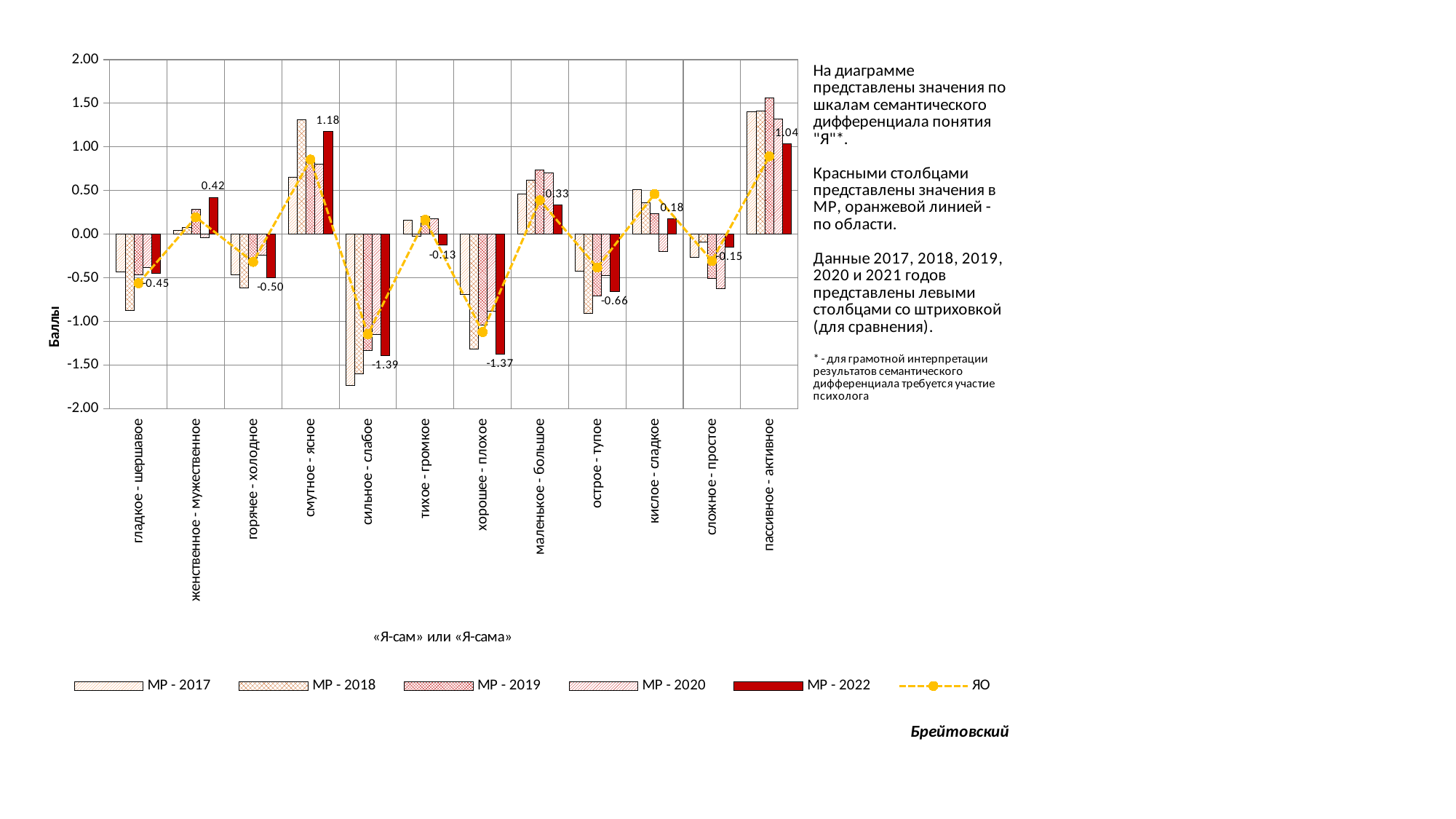
How many series does the legend list? 6 How many categories are shown on the x axis? 12 Which category has the highest МР - 2022 value? смутное - ясное What is the МР - 2022 value for острое - тупое? -0.66 Is the МР - 2017 value for гладкое - шершавое greater or less than -0.50? greater What is the МР - 2022 value for смутное - ясное? 1.18 What is the difference between the МР - 2022 values for смутное - ясное and пассивное - активное? 0.14 What kind of chart is shown on the slide? A bar chart combined with a line chart What is the title of the vertical axis? Баллы Which category has the lowest МР - 2022 value? сильное - слабое What is the МР - 2022 value for сильное - слабое? -1.39 Which has the larger МР - 2022 value: женственное - мужественное or маленькое - большое? женственное - мужественное